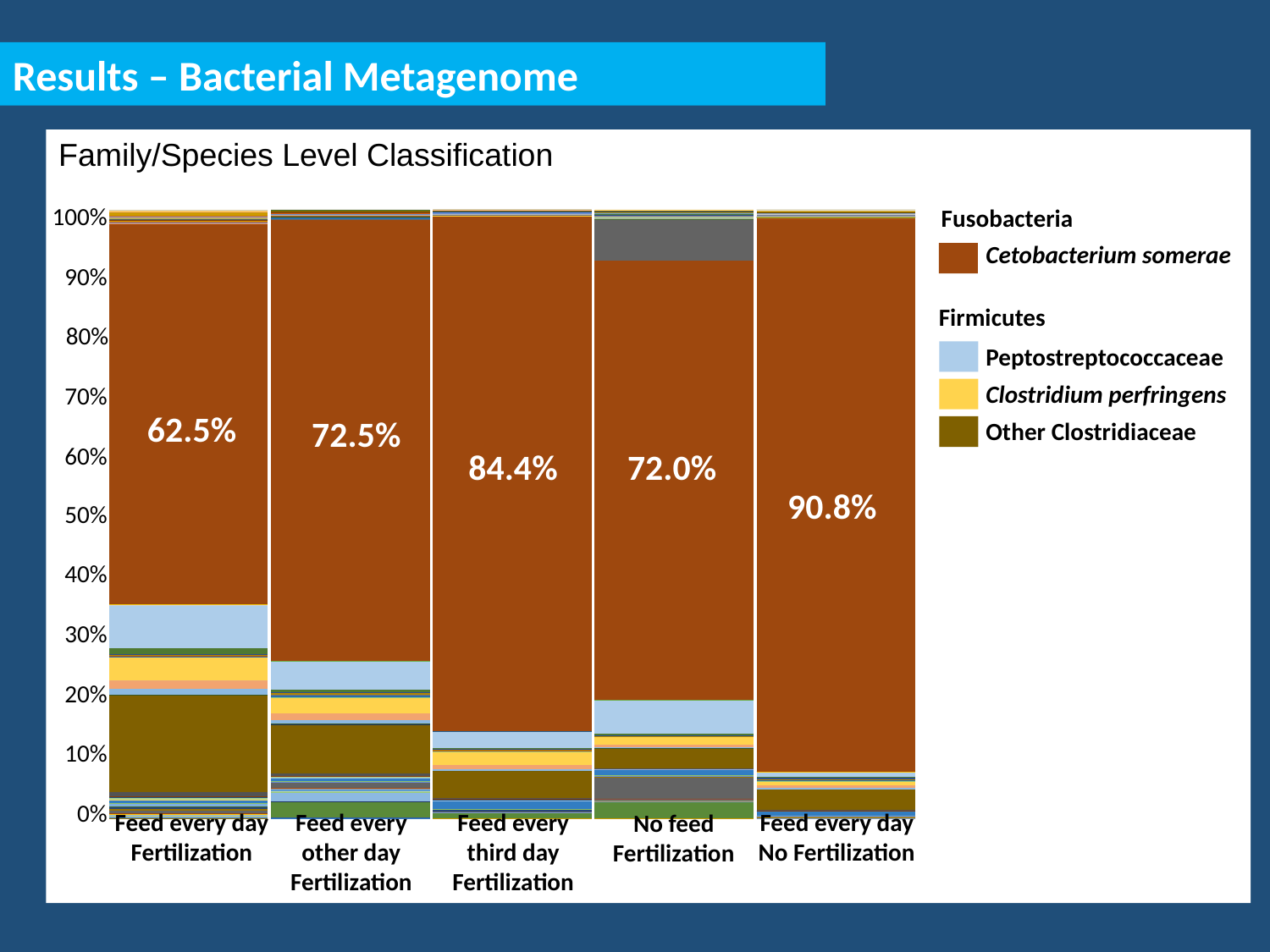
How many bars (treatment groups) are shown on the chart? 5 How many named taxa does the legend list with colour swatches? 4 Which bar has the highest labelled Cetobacterium somerae percentage? Feed every day No Fertilization Which has a larger labelled Cetobacterium somerae percentage: "Feed every other day Fertilization" or "Feed every third day Fertilization"? Feed every third day Fertilization Which legend entry is listed under the Fusobacteria heading? Cetobacterium somerae What is the labelled Cetobacterium somerae percentage for the "Feed every day No Fertilization" bar? 90.8% What is the difference between the labelled Cetobacterium somerae percentages for "Feed every day No Fertilization" and "Feed every day Fertilization"? 28.3% What is the labelled Cetobacterium somerae percentage for the "Feed every third day Fertilization" bar? 84.4% Which bar has the lowest labelled Cetobacterium somerae percentage? Feed every day Fertilization What is the labelled Cetobacterium somerae percentage for the "No feed Fertilization" bar? 72.0% What kind of chart is shown on the slide? Stacked bar chart What is the labelled Cetobacterium somerae percentage for the "Feed every day Fertilization" bar? 62.5%